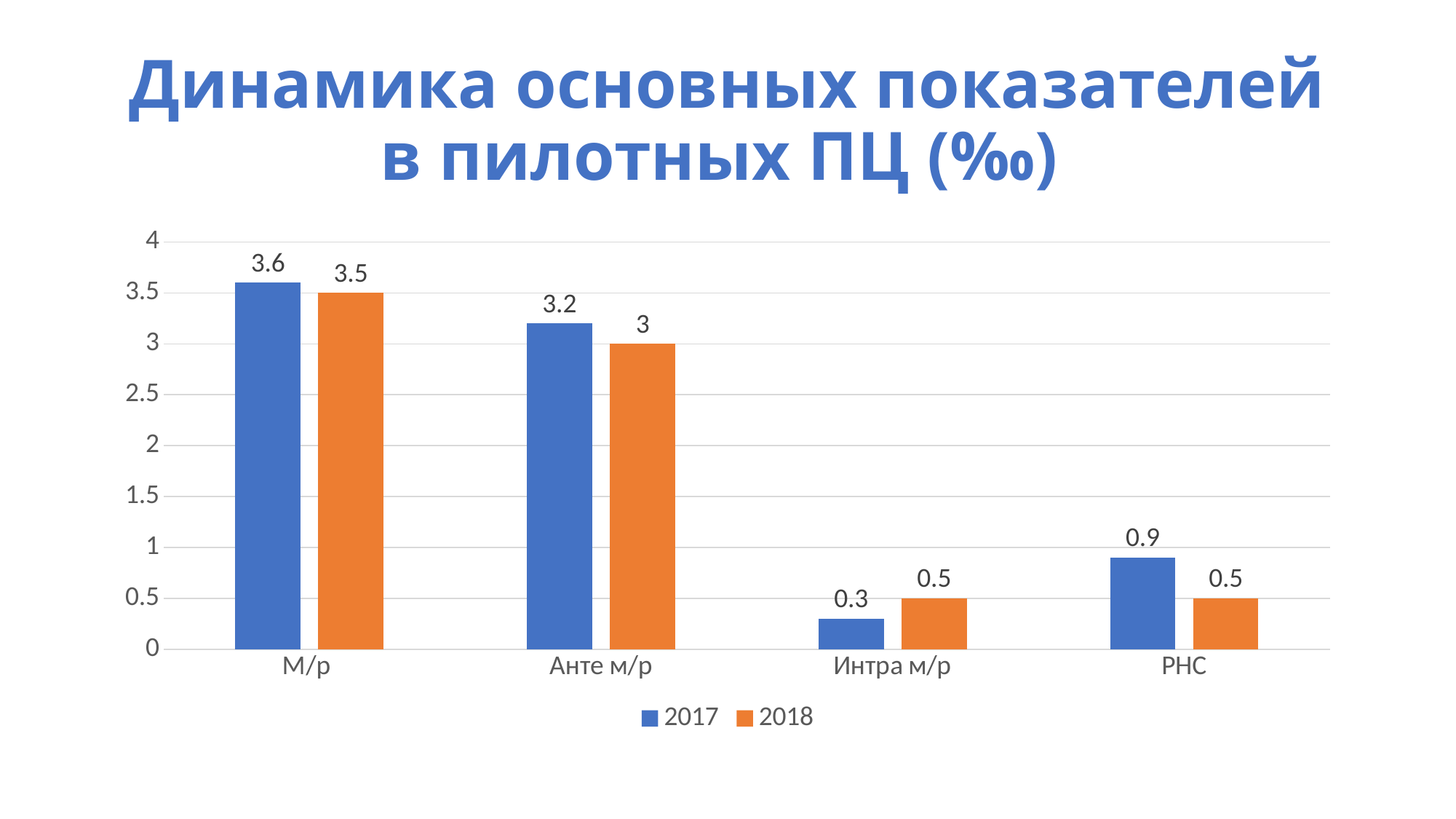
What kind of chart is shown on the slide? Bar chart How many series does the legend list? 2 Which category has the lowest value in 2018? Интра м/р and РНС (both 0.5) How many categories are shown on the x axis? 4 What is the value for Интра м/р in 2017? 0.3 Which colour represents the 2018 series? Orange What is the value for Анте м/р in 2018? 3 What is the value for РНС in 2018? 0.5 What is the value for М/р in 2017? 3.6 Which is larger for Интра м/р: the 2017 value or the 2018 value? 2018 What is the difference between the 2017 and 2018 values for РНС? 0.4 Which category has the highest value in 2017? М/р